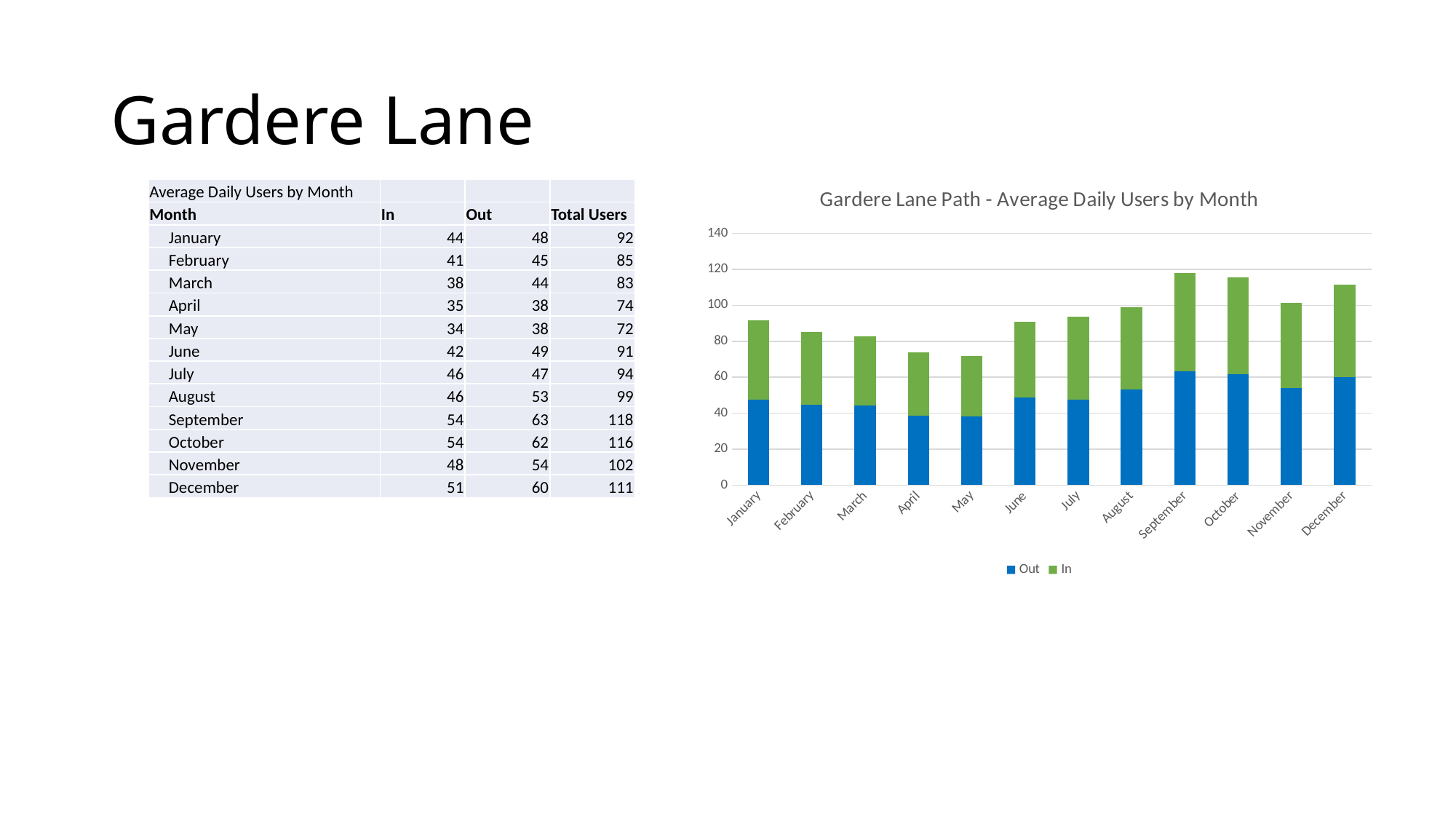
Which series is shown in green in the chart? In Is the total bar for October greater or less than 100? greater Which month has the lowest total bar in the chart? May How many months are plotted on the x axis of the chart? 12 What is the Out value for December? 60 How many series does the chart legend list? 2 What is the difference between the total users in September and in May? 46 What kind of chart is shown on the slide? Stacked bar chart Which month has the highest total bar in the chart? September What is the In value for April? 35 What is the total of the stacked bar for September? 118 Which is larger, the total bar for January or the total bar for April? January